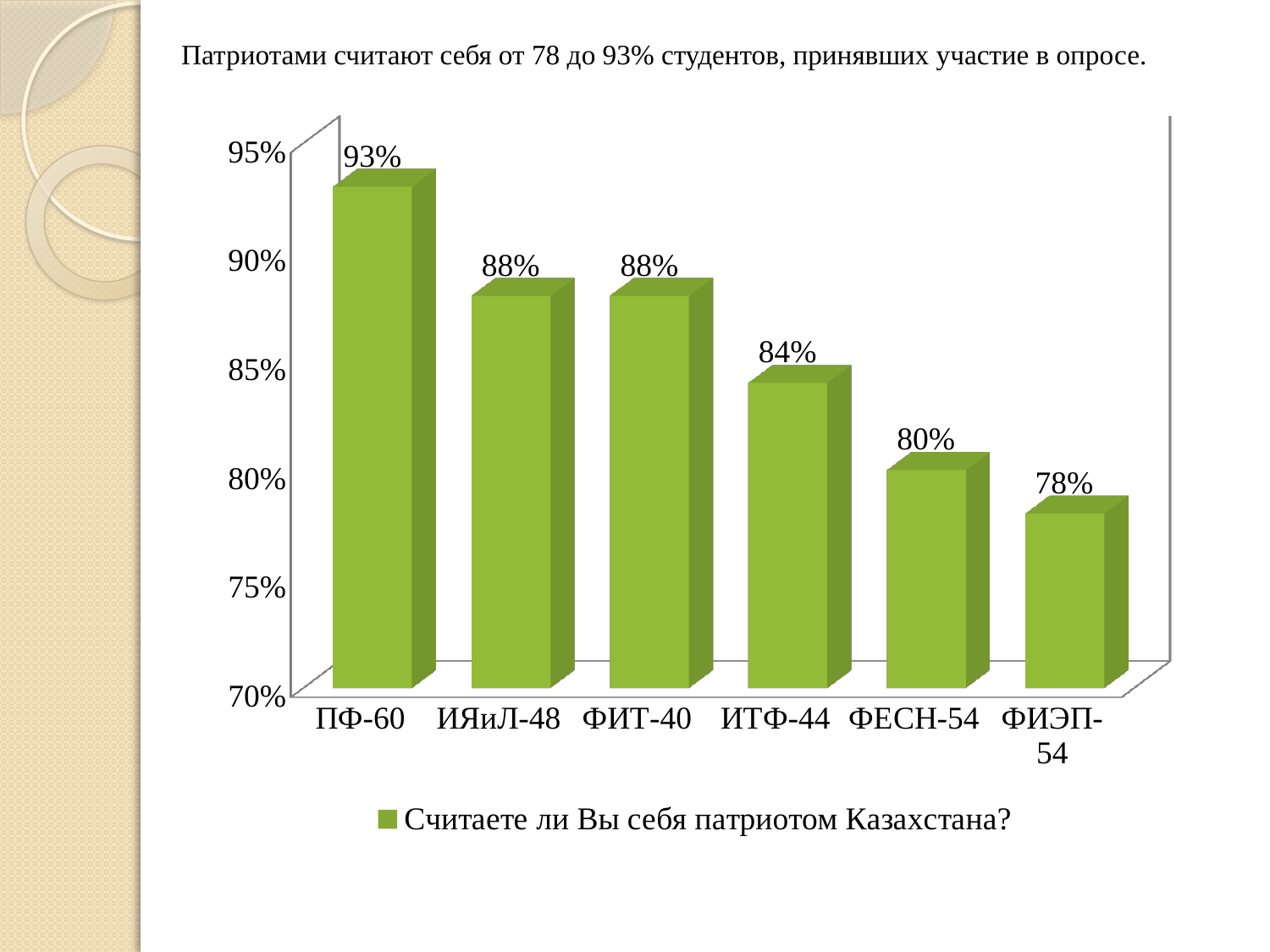
Do the values rise or fall from left to right along the x axis? Fall What is the difference between the values for ПФ-60 and ФИЭП-54? 15% What is the difference between the values for ИЯиЛ-48 and ИТФ-44? 4% What is the value for ИТФ-44? 84% What is the value for ПФ-60? 93% What is the value for ФИЭП-54? 78% Which category has the highest value? ПФ-60 What is the value for ФЕСН-54? 80% How many categories are shown on the x axis? 6 Which is larger, the value for ФИТ-40 or the value for ФЕСН-54? ФИТ-40 What kind of chart is shown on the slide? Bar chart Which category has the lowest value? ФИЭП-54